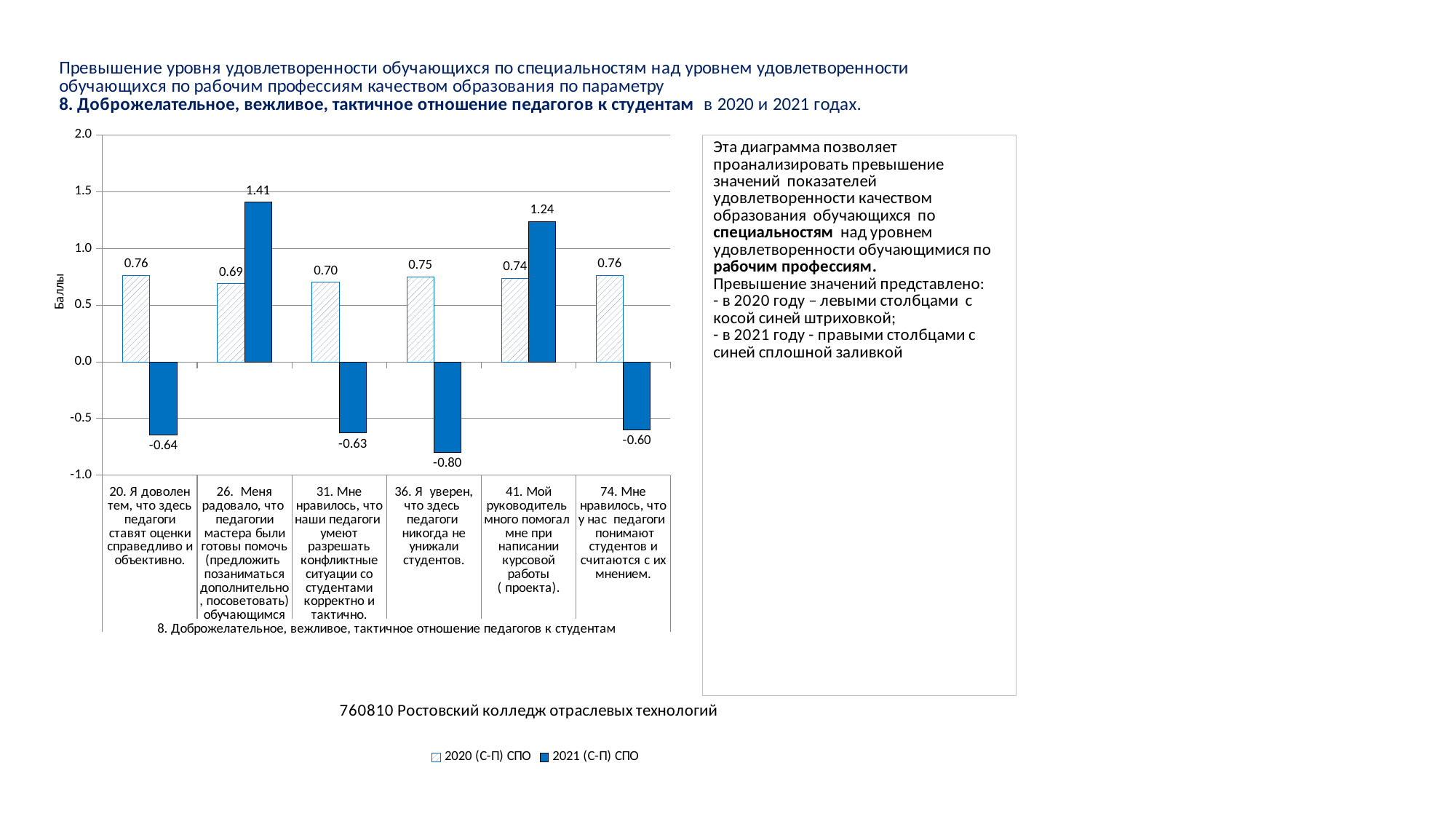
Which statement has the highest value in the 2021 (С-П) СПО series? 26. Меня радовало, что педагоги мастера были готовы помочь What is the value of the 2021 (С-П) СПО series for statement 36 ("Я уверен, что здесь педагоги никогда не унижали студентов")? -0.80 How many statements (categories) are shown on the x axis of the chart? 6 What type of chart is shown on the slide? Bar chart What is the value of the 2020 (С-П) СПО series for statement 41 ("Мой руководитель много помогал мне при написании курсовой работы")? 0.74 What is the difference between the 2021 and 2020 values for statement 41 ("Мой руководитель много помогал мне...")? 0.50 What is the label of the vertical axis of the chart? Баллы What is the value of the 2020 (С-П) СПО series for statement 36 ("Я уверен, что здесь педагоги никогда не унижали студентов")? 0.75 For statement 20 ("Я доволен тем, что здесь педагоги ставят оценки справедливо и объективно"), which series has the larger value, 2020 (С-П) СПО or 2021 (С-П) СПО? 2020 (С-П) СПО How many series does the chart legend list? 2 What is the value of the 2021 (С-П) СПО series for statement 26 ("Меня радовало, что педагоги мастера были готовы помочь...")? 1.41 Which statement has the lowest value in the 2021 (С-П) СПО series? 36. Я уверен, что здесь педагоги никогда не унижали студентов